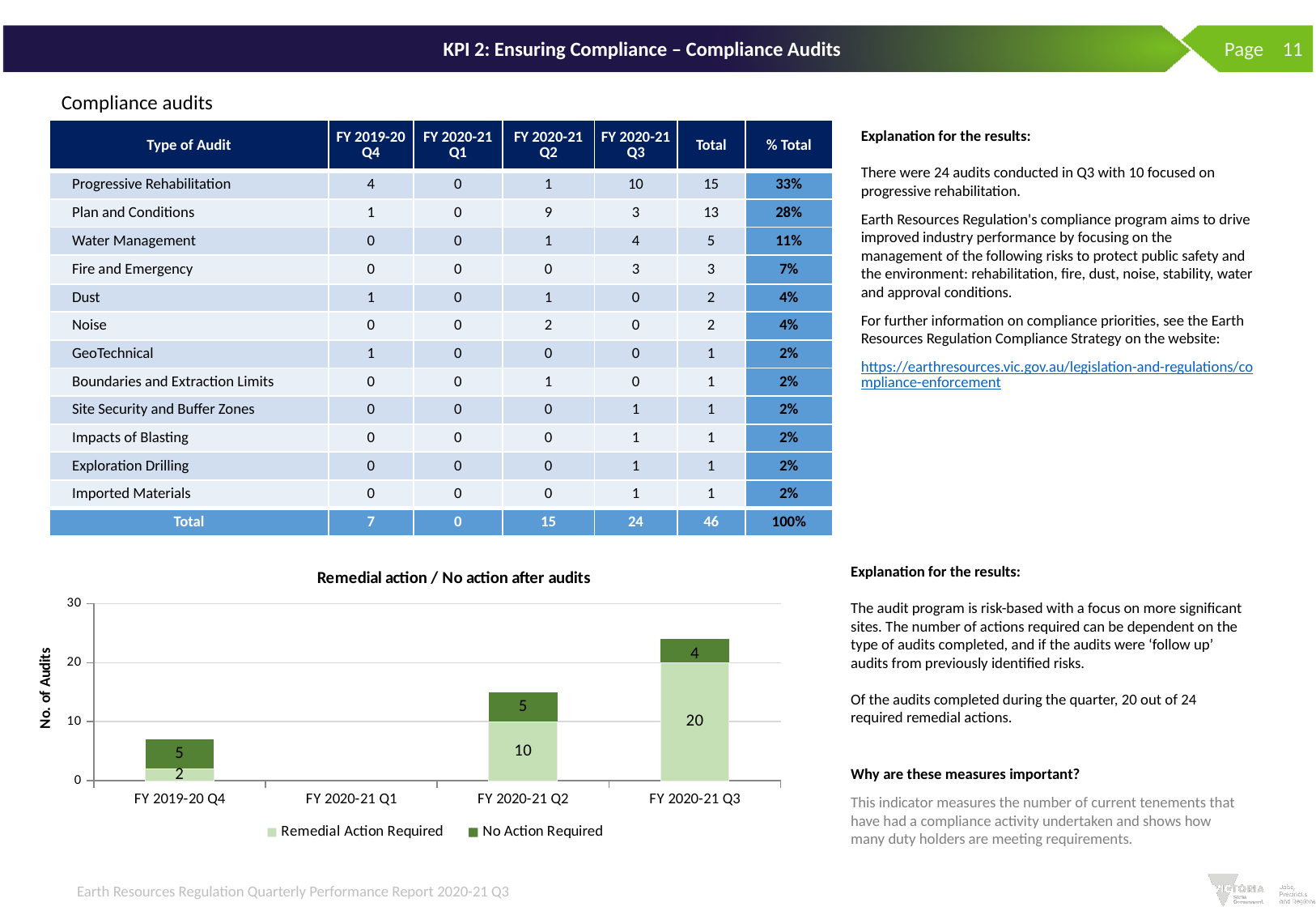
In the 'Remedial action / No action after audits' chart, what is the value for Remedial Action Required in FY 2020-21 Q3? 20 In the 'Remedial action / No action after audits' chart, what is the total height of the stacked bar for FY 2020-21 Q2? 15 In the 'Remedial action / No action after audits' chart, is the No Action Required value larger in FY 2019-20 Q4 or FY 2020-21 Q3? FY 2019-20 Q4 In the 'Remedial action / No action after audits' chart, what is the total height of the stacked bar for FY 2020-21 Q3? 24 How many quarters are shown on the x axis of the 'Remedial action / No action after audits' chart? 4 In the 'Remedial action / No action after audits' chart, is the total stacked bar for FY 2020-21 Q3 greater or less than 20? greater What type of chart is 'Remedial action / No action after audits'? Stacked bar chart In the 'Remedial action / No action after audits' chart, what is the value for Remedial Action Required in FY 2019-20 Q4? 2 How many series does the legend of the 'Remedial action / No action after audits' chart list? 2 In the 'Remedial action / No action after audits' chart, which quarter has the highest number of Remedial Action Required? FY 2020-21 Q3 In the 'Remedial action / No action after audits' chart, what is the value for No Action Required in FY 2020-21 Q2? 5 In the 'Remedial action / No action after audits' chart, what is the difference between Remedial Action Required in FY 2020-21 Q3 and FY 2020-21 Q2? 10